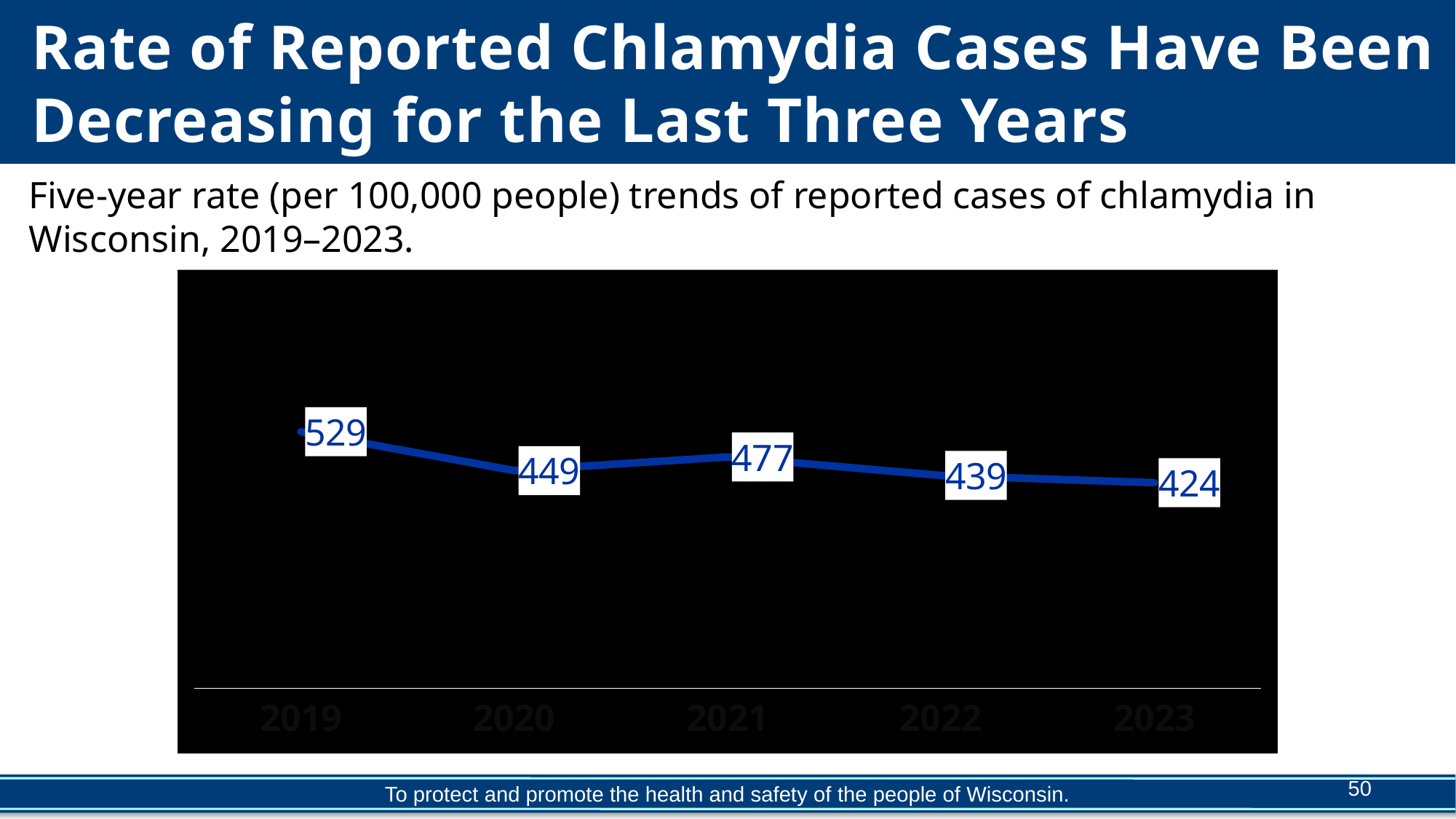
What was the rate of reported chlamydia cases in Wisconsin in 2019? 529 Which year had the lowest rate of reported chlamydia cases? 2023 Which year had the highest rate of reported chlamydia cases? 2019 By how much did the rate change from 2020 to 2021? 28 What kind of chart is shown on the slide? Line chart What was the rate of reported chlamydia cases in Wisconsin in 2021? 477 What is the first year shown on the x axis? 2019 Which year had a higher rate, 2020 or 2022? 2020 What was the rate of reported chlamydia cases in Wisconsin in 2023? 424 How many years are plotted on the chart? 5 What is the difference between the 2019 rate and the 2023 rate? 105 Did the rate rise or fall from 2021 to 2023? Fall